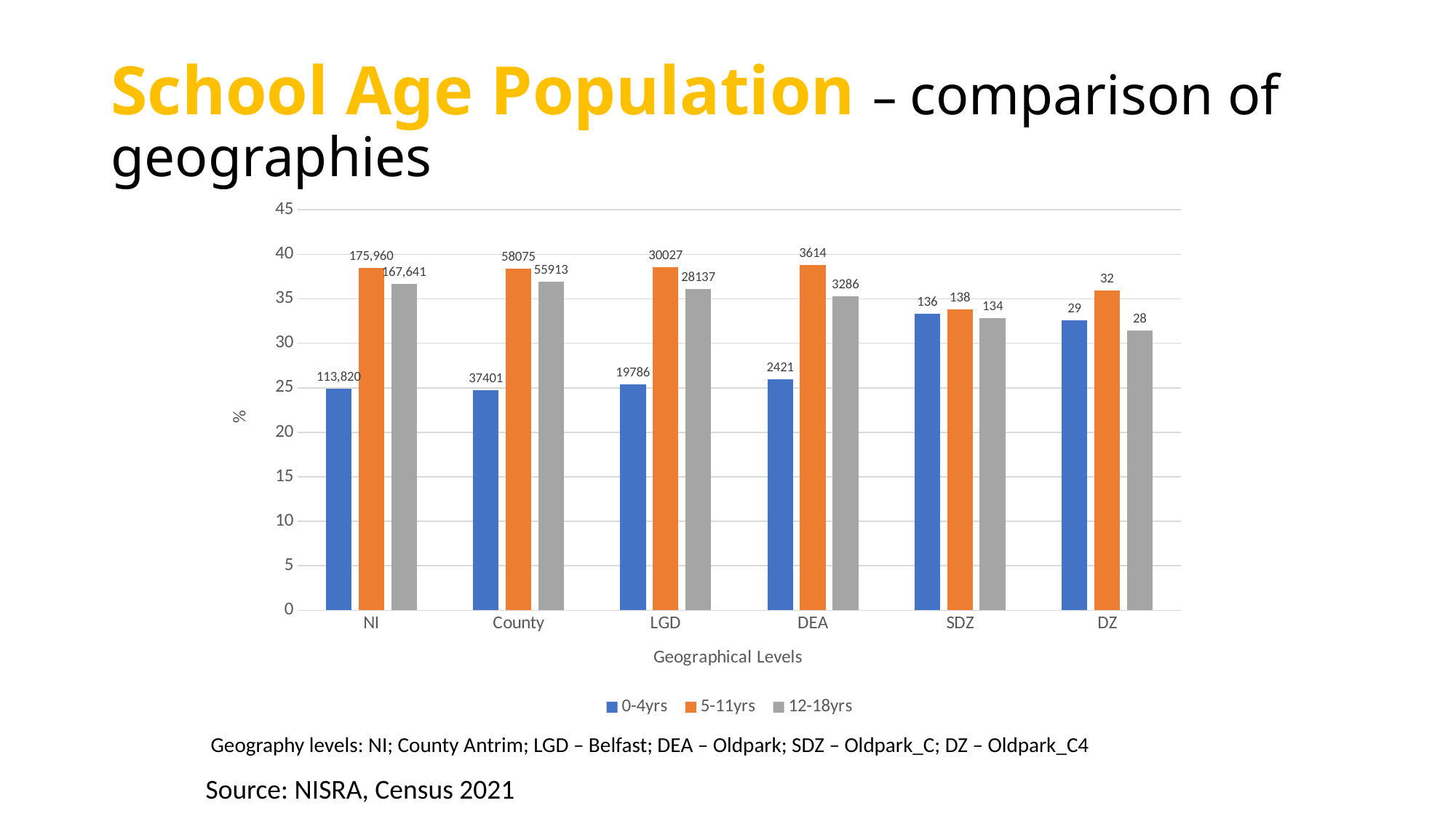
What data label is shown on the 0-4yrs bar for County? 37401 For NI, which bar is taller: 0-4yrs or 5-11yrs? 5-11yrs Is the plotted value for the 5-11yrs bar for DEA greater or less than 35? greater What data label is shown on the 5-11yrs bar for DZ? 32 What is the title of the x axis? Geographical Levels What data label is shown on the 12-18yrs bar for DEA? 3286 How many geographical levels are shown on the x axis? 6 Is the plotted value for the 0-4yrs bar for NI greater or less than 30? less What data label is shown on the 5-11yrs bar for NI? 175,960 What type of chart is shown on the slide? bar chart How many series does the legend list? 3 For DZ, which age group has the tallest bar? 5-11yrs